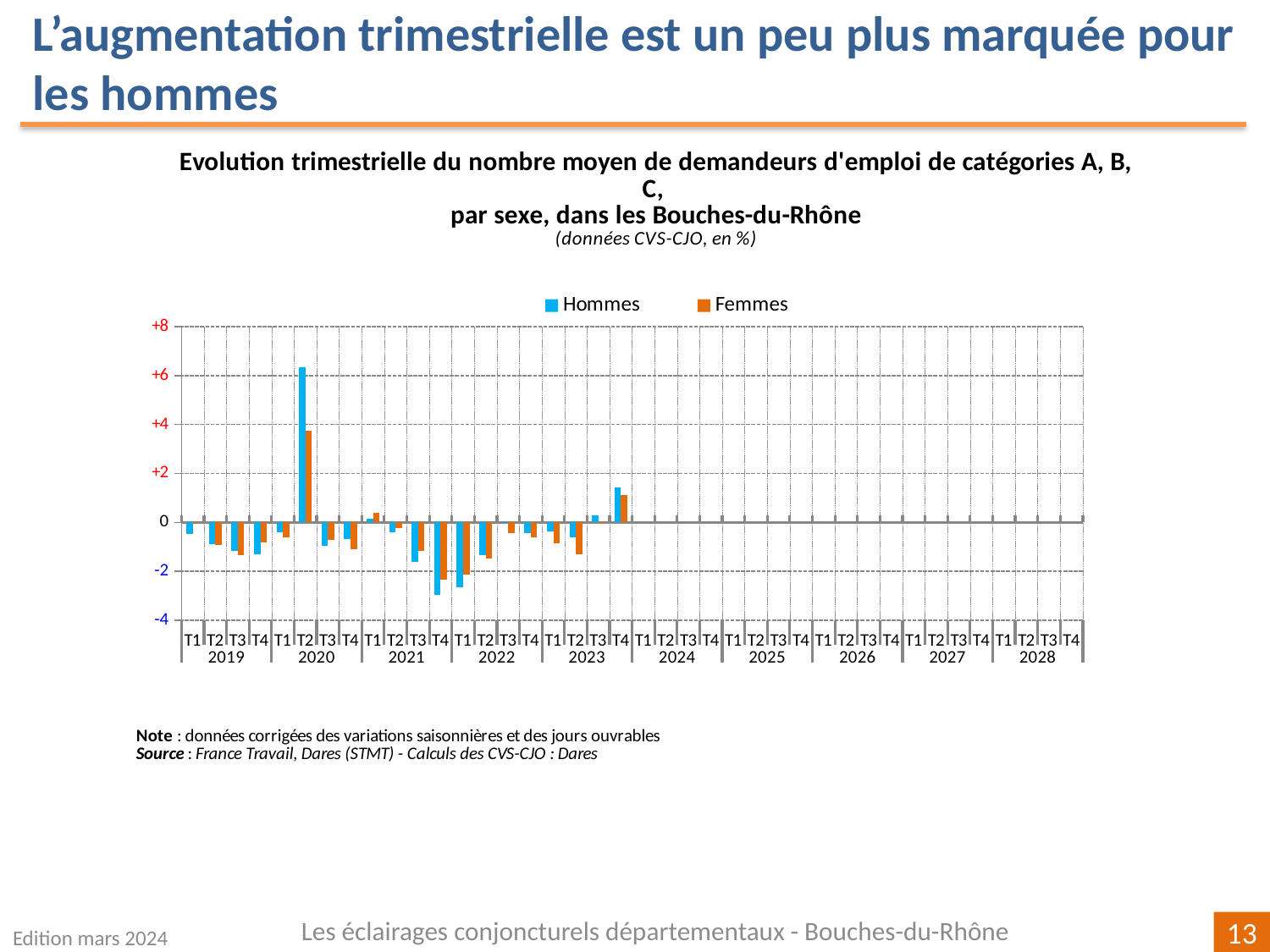
Is the Hommes value for T4 2021 greater or less than -2? less In which quarter is the Hommes value highest? T2 2020 How many series does the legend list? 2 Is the Hommes value for T2 2020 greater or less than +4? greater In T2 2020, which series has the larger value, Hommes or Femmes? Hommes What kind of chart is shown on the slide? bar chart Which two series are shown in the legend? Hommes and Femmes Is the Hommes value for T4 2023 greater or less than +2? less How many years are labelled on the x axis? 10 Which colour represents the Femmes series? orange In which quarter is the Hommes value lowest? T4 2021